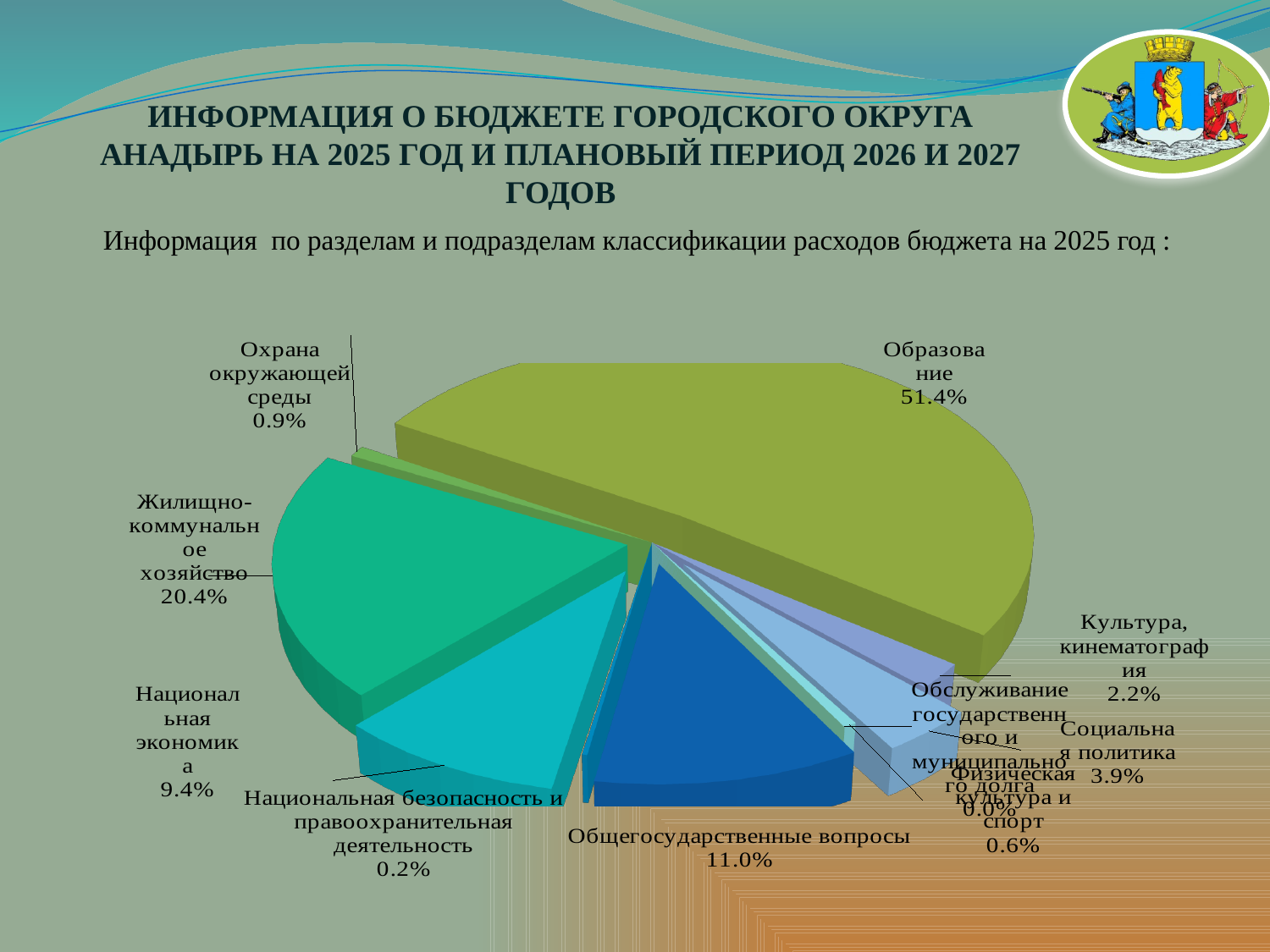
Сколько разделов расходов показано на диаграмме? 10 Какая доля расходов приходится на раздел «Образование»? 51.4% Какая доля расходов приходится на раздел «Жилищно-коммунальное хозяйство»? 20.4% Какая доля расходов приходится на раздел «Социальная политика»? 3.9% Какая доля расходов приходится на раздел «Национальная экономика»? 9.4% Какой раздел имеет наибольшую долю расходов на диаграмме? Образование Какая доля расходов приходится на раздел «Общегосударственные вопросы»? 11.0% Какой раздел имеет наименьшую долю расходов на диаграмме? Обслуживание государственного и муниципального долга Какой тип диаграммы используется на слайде? Круговая диаграмма Какая доля расходов приходится на раздел «Охрана окружающей среды»? 0.9% Что больше: доля раздела «Общегосударственные вопросы» или доля раздела «Национальная экономика»? Общегосударственные вопросы На сколько процентных пунктов доля раздела «Образование» больше доли раздела «Жилищно-коммунальное хозяйство»? 31.0